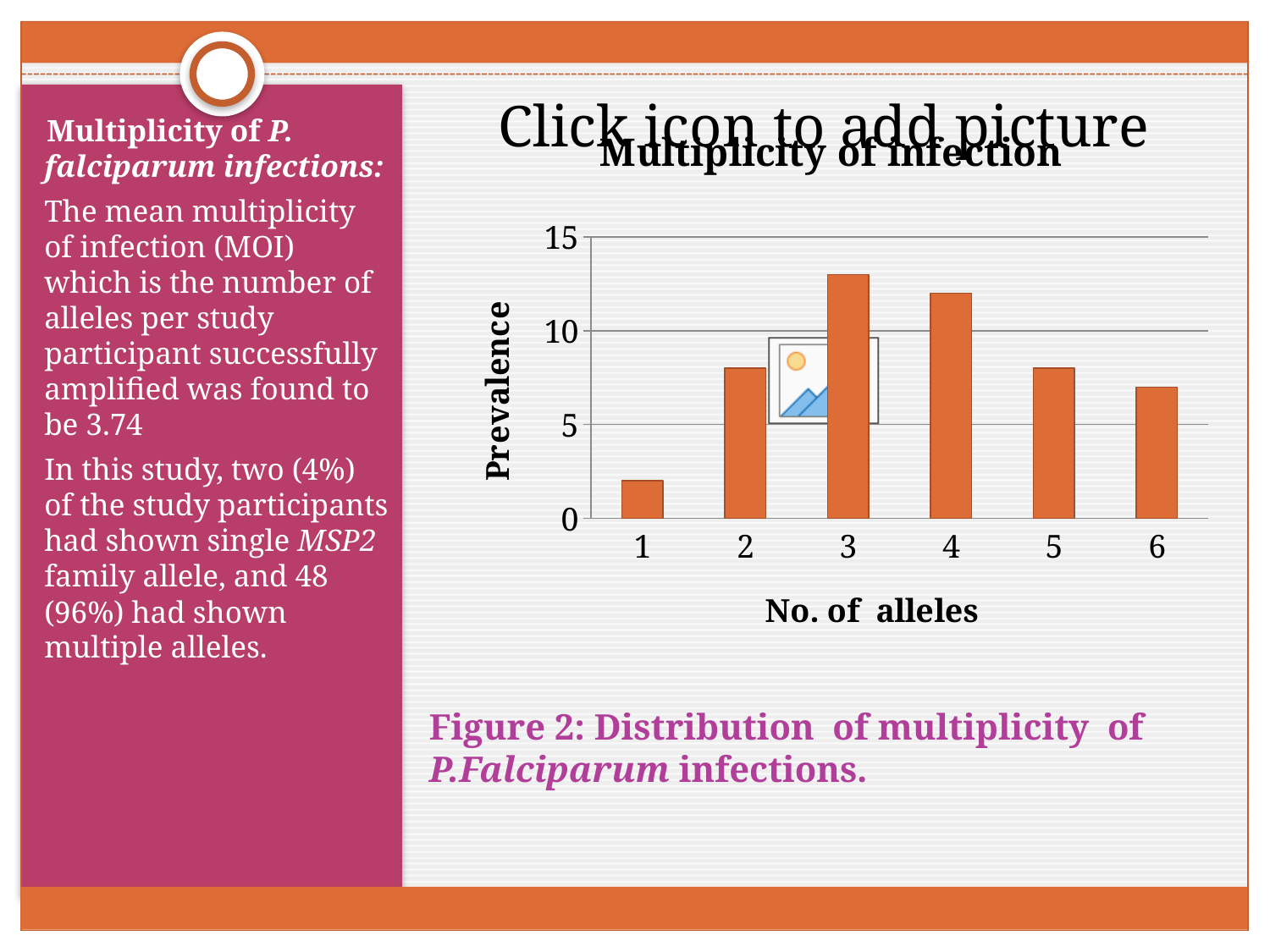
Which number of alleles has the highest prevalence? 3 Is the prevalence for 6 alleles greater or less than 10? less What is the label of the x axis of the chart? No. of alleles What kind of chart is shown on the slide? bar chart How many categories (numbers of alleles) are plotted on the chart? 6 What is the title of the chart? Multiplicity of infection Is the prevalence for 1 allele greater or less than 5? less Which has the larger prevalence, 1 allele or 6 alleles? 6 alleles Is the prevalence for 3 alleles greater or less than 10? greater From 3 alleles to 6 alleles, does the prevalence rise or fall? fall Which number of alleles has the lowest prevalence? 1